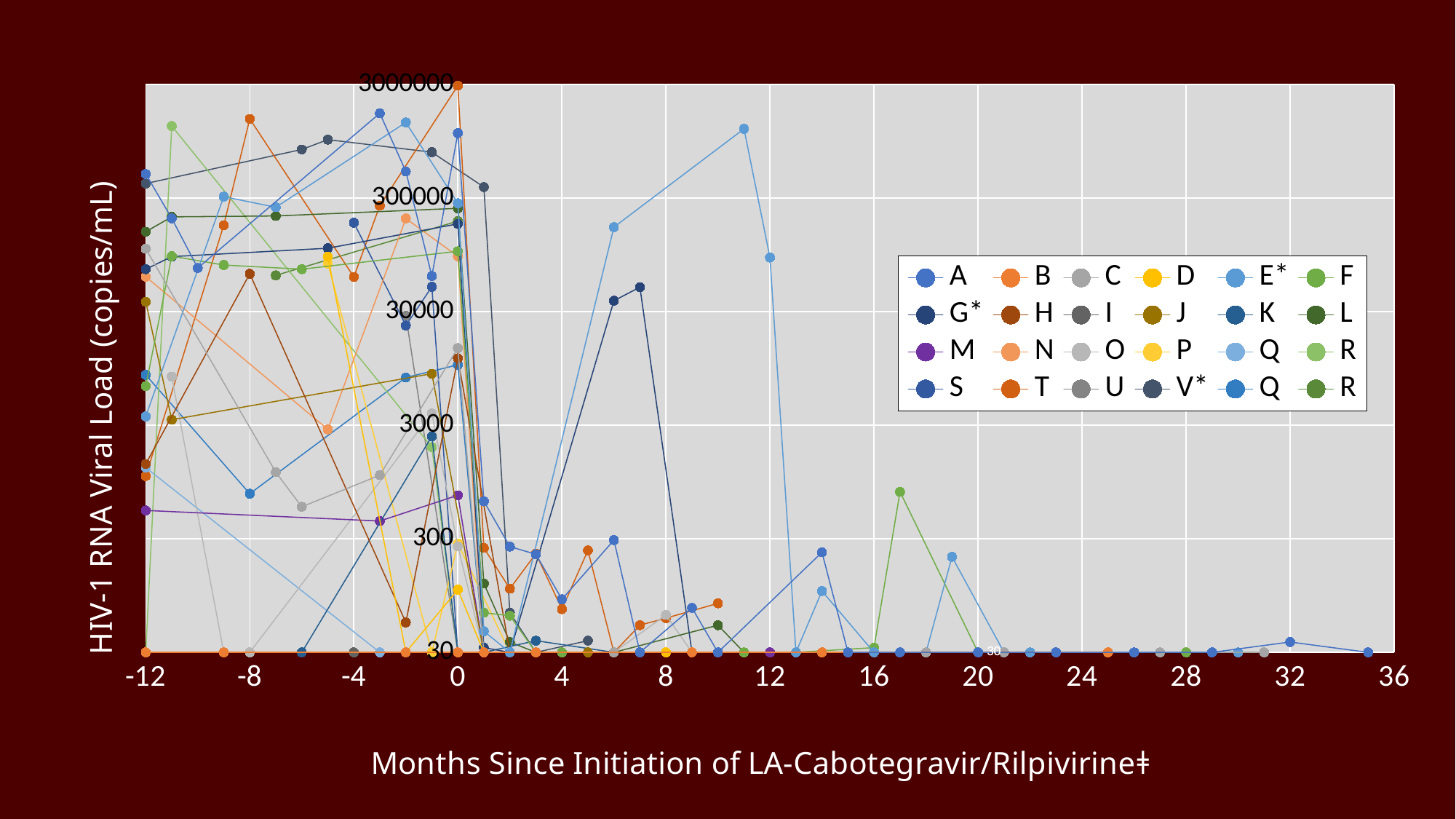
Is the highest value plotted at month 11 greater or less than 300000? greater What is the highest tick value shown on the y axis? 3000000 Is the value plotted at month 35 greater or less than 300? less How many tick labels are shown on the x axis? 13 Is the highest value plotted at month 17 greater or less than 3000? less At which month on the x axis does the single highest plotted point occur? 0 After month 0, do the plotted viral load values generally rise or fall? fall What kind of chart is shown on the slide? line chart What is the title of the x axis? Months Since Initiation of LA-Cabotegravir/Rilpivirine‡ Which legend entries are marked with an asterisk? E*, G*, V* How many series does the legend list? 24 What is the lowest tick value shown on the y axis? 30